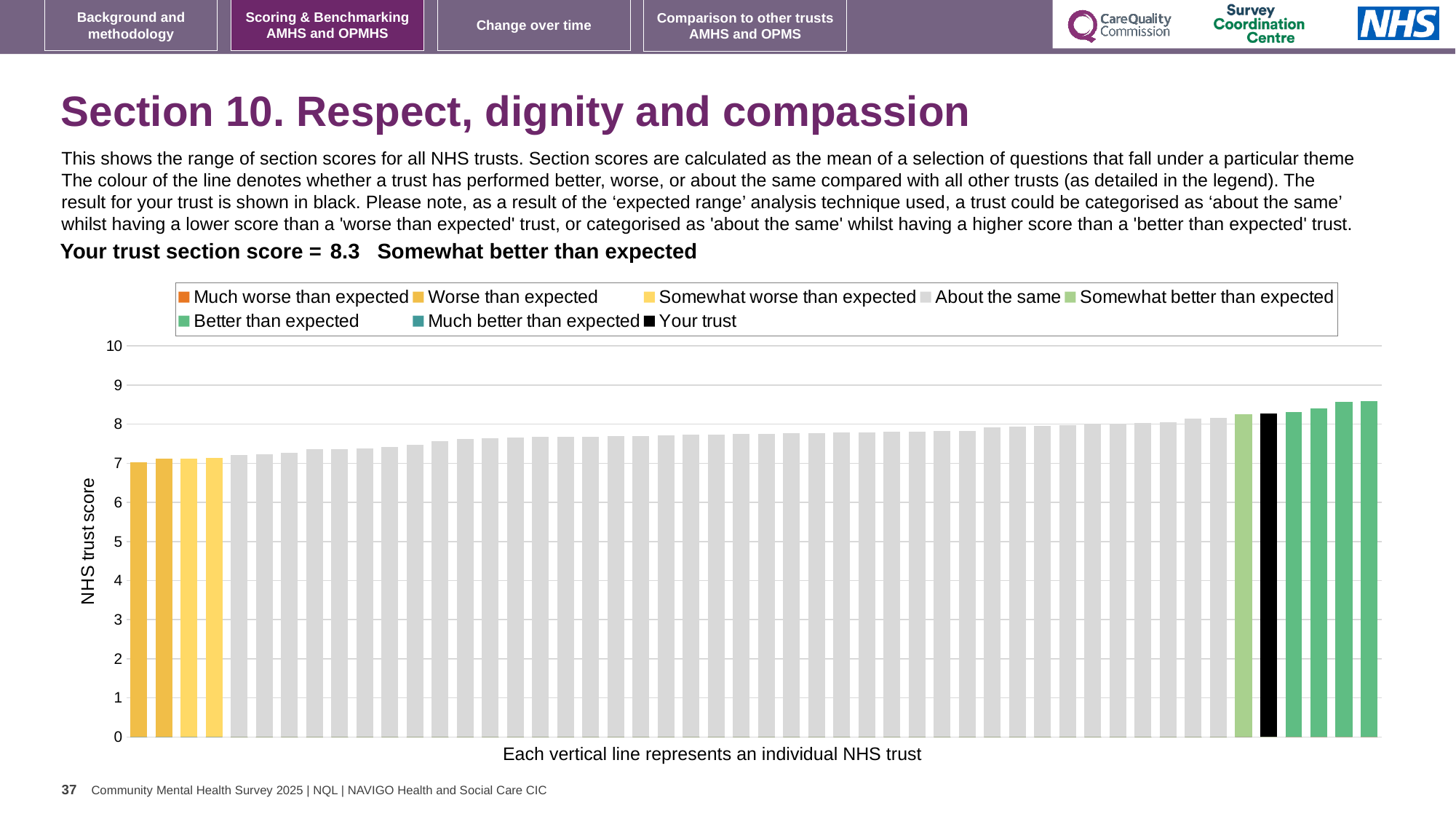
Do the bar values rise or fall from left to right along the x axis? Rise Is the value of the rightmost bar greater or less than 8? greater Which is larger, the value of the black 'Your trust' bar or the value of the leftmost bar? The black 'Your trust' bar Is the value of the black 'Your trust' bar greater or less than 8? greater How many bars are coloured in the 'Somewhat better than expected' light green shade? 1 What is the section score for your trust shown on the slide? 8.3 How many bars are coloured in the 'Better than expected' green shade? 4 Is the value of the leftmost bar greater or less than 8? less What is the label on the vertical axis of the chart? NHS trust score How many entries does the chart legend list? 8 Which legend category does your trust fall into for this section? Somewhat better than expected What kind of chart is shown on the slide? Bar chart